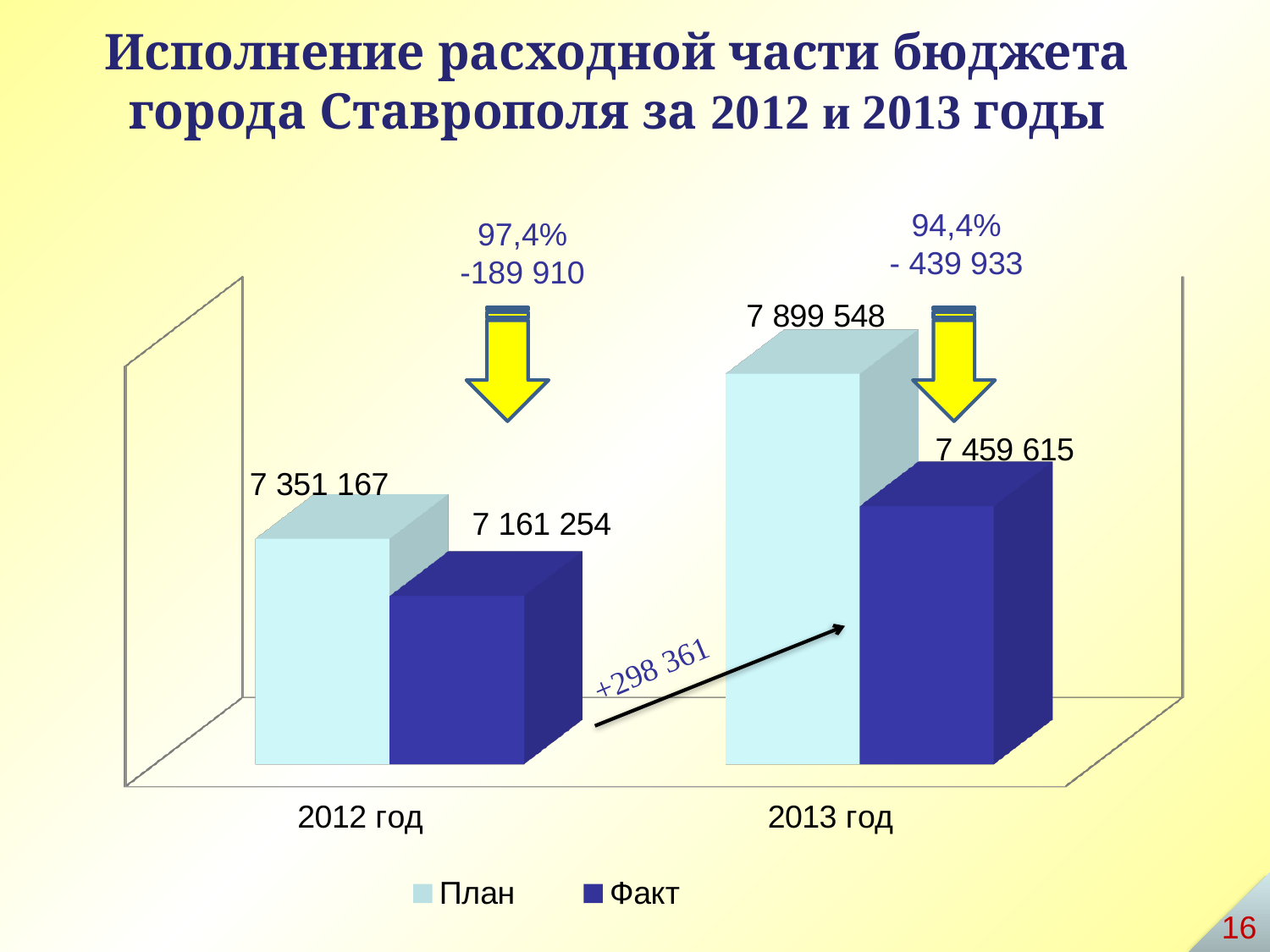
What is the Факт value for 2013 год? 7 459 615 What is the Факт value for 2012 год? 7 161 254 What is the difference between the Факт values for 2013 год and 2012 год? 298 361 What is the План value for 2013 год? 7 899 548 Which bar is the lowest on the chart? Факт for 2012 год What is the difference between План and Факт for 2013 год? 439 933 Is the Факт value for 2012 год larger or smaller than the План value for 2012 год? smaller What kind of chart is shown on the slide? bar chart Which year has the higher План value? 2013 год What is the План value for 2012 год? 7 351 167 What percentage of the plan was executed in 2013 according to the annotation? 94,4% How many series does the legend list? 2